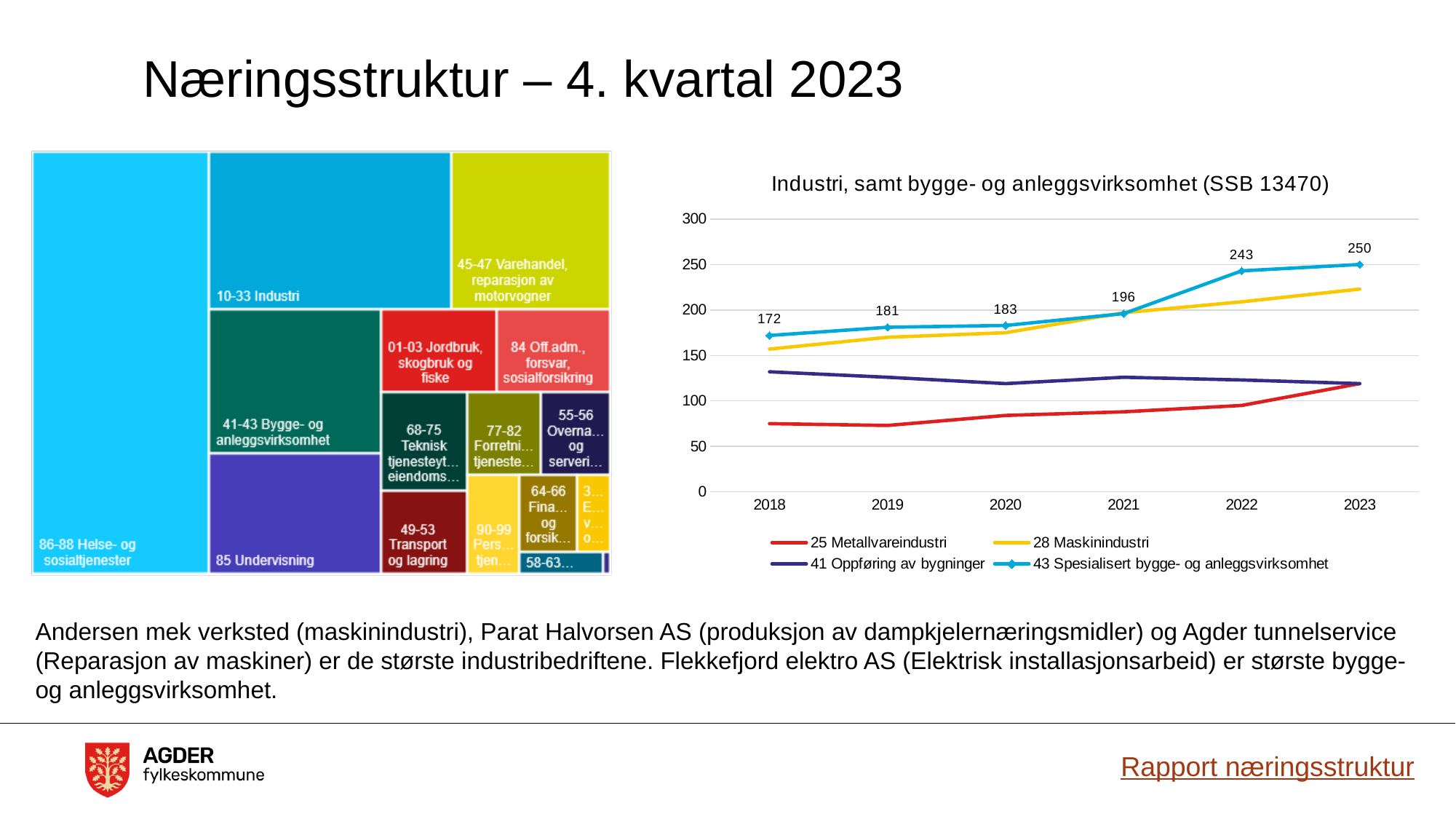
In the line chart on the right, what is the difference between the 2022 and 2021 values for 43 Spesialisert bygge- og anleggsvirksomhet? 47 In the line chart on the right, what is the value for 43 Spesialisert bygge- og anleggsvirksomhet in 2023? 250 In the line chart on the right, what is the value for 43 Spesialisert bygge- og anleggsvirksomhet in 2021? 196 In the line chart on the right, which is larger in 2023: 28 Maskinindustri or 41 Oppføring av bygninger? 28 Maskinindustri In the line chart titled 'Industri, samt bygge- og anleggsvirksomhet (SSB 13470)', what is the value for 43 Spesialisert bygge- og anleggsvirksomhet in 2018? 172 What kind of chart is the chart on the right of the slide? line chart How many years are shown on the x axis of the line chart on the right? 6 In the line chart on the right, by how much did 43 Spesialisert bygge- og anleggsvirksomhet increase from 2018 to 2023? 78 In the line chart on the right, is the value for 25 Metallvareindustri in 2018 greater or less than 100? less How many series does the legend of the line chart on the right list? 4 In the line chart on the right, does the line for 43 Spesialisert bygge- og anleggsvirksomhet rise or fall from 2018 to 2023? rise In the line chart on the right, in which year is 43 Spesialisert bygge- og anleggsvirksomhet at its lowest? 2018